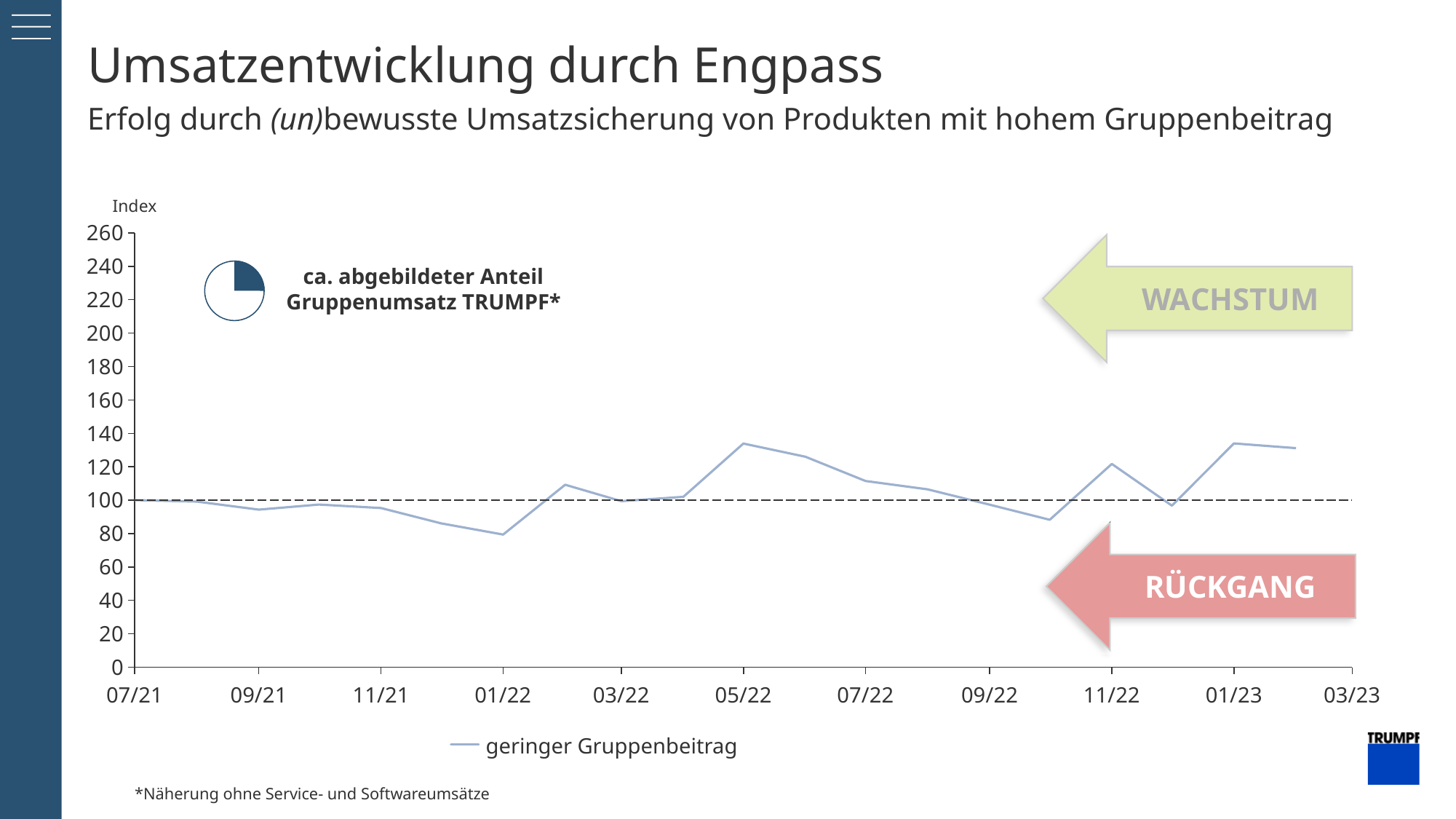
What kind of chart is shown on the slide? line chart Does the line rise or fall between 11/21 and 01/22? fall Which month has the lowest value on the chart? 01/22 What is the name of the series shown in the legend? geringer Gruppenbeitrag Does the line rise or fall between 01/22 and 05/22? rise Is the value for 01/22 greater or less than 100? less Is the value for 05/22 greater or less than 120? greater Is the value for 11/22 greater or less than 100? greater How many series does the legend list? 1 Which is larger, the value for 05/22 or the value for 01/22? 05/22 What is the label of the y axis? Index